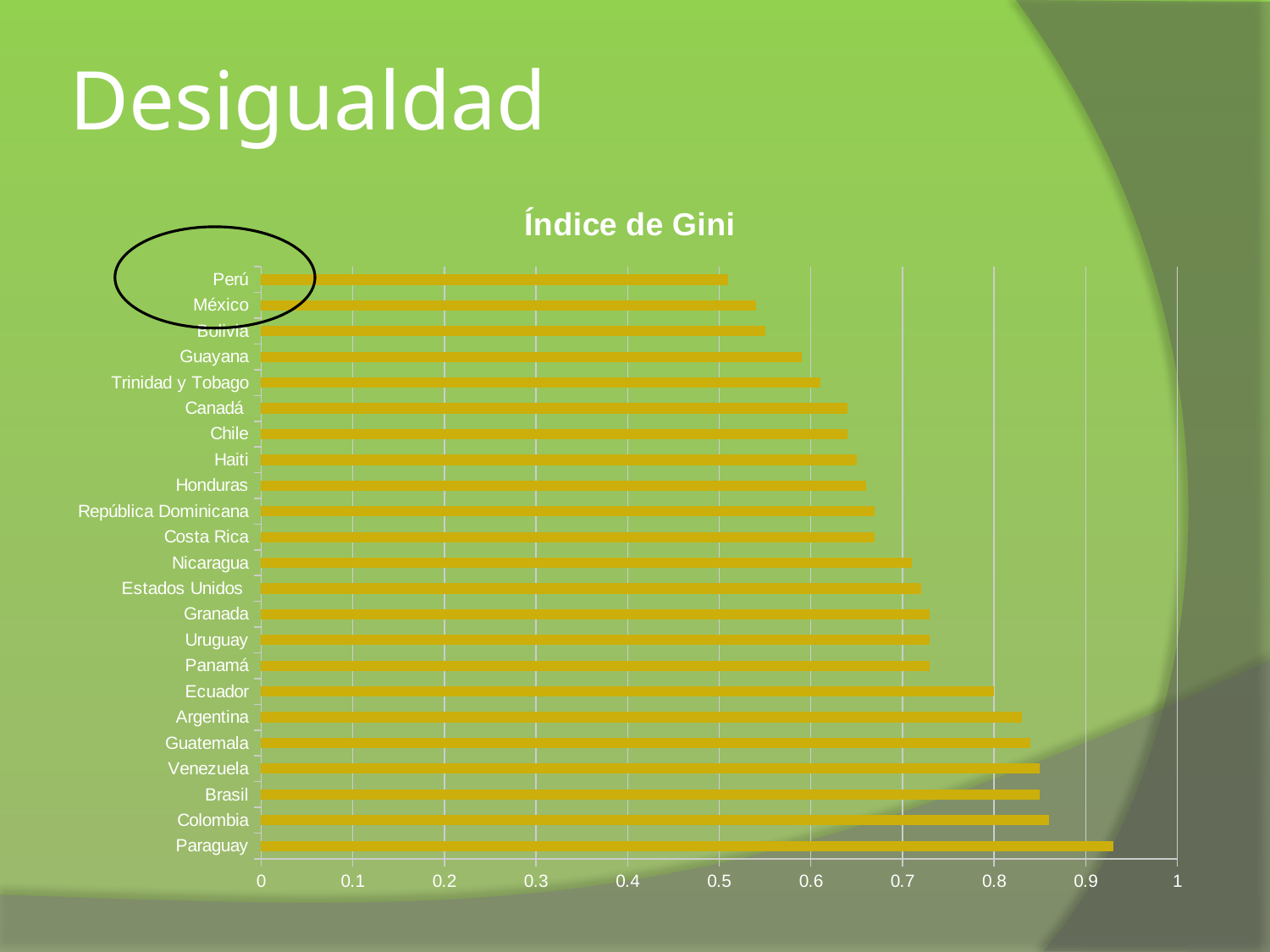
Is the value for Canadá greater or less than 0.7? less Is the value for Perú greater or less than 0.6? less Is the value for Paraguay greater or less than 0.9? greater Which has a larger value, Bolivia or Colombia? Colombia Which country has the lowest value in the chart? Perú How many countries are plotted in the chart? 23 What kind of chart is shown on the slide? bar chart Do the bar values increase or decrease going from Perú at the top to Paraguay at the bottom? increase Which country has the highest value in the chart? Paraguay Which has a larger value, Argentina or Chile? Argentina What is the title of the chart? Índice de Gini